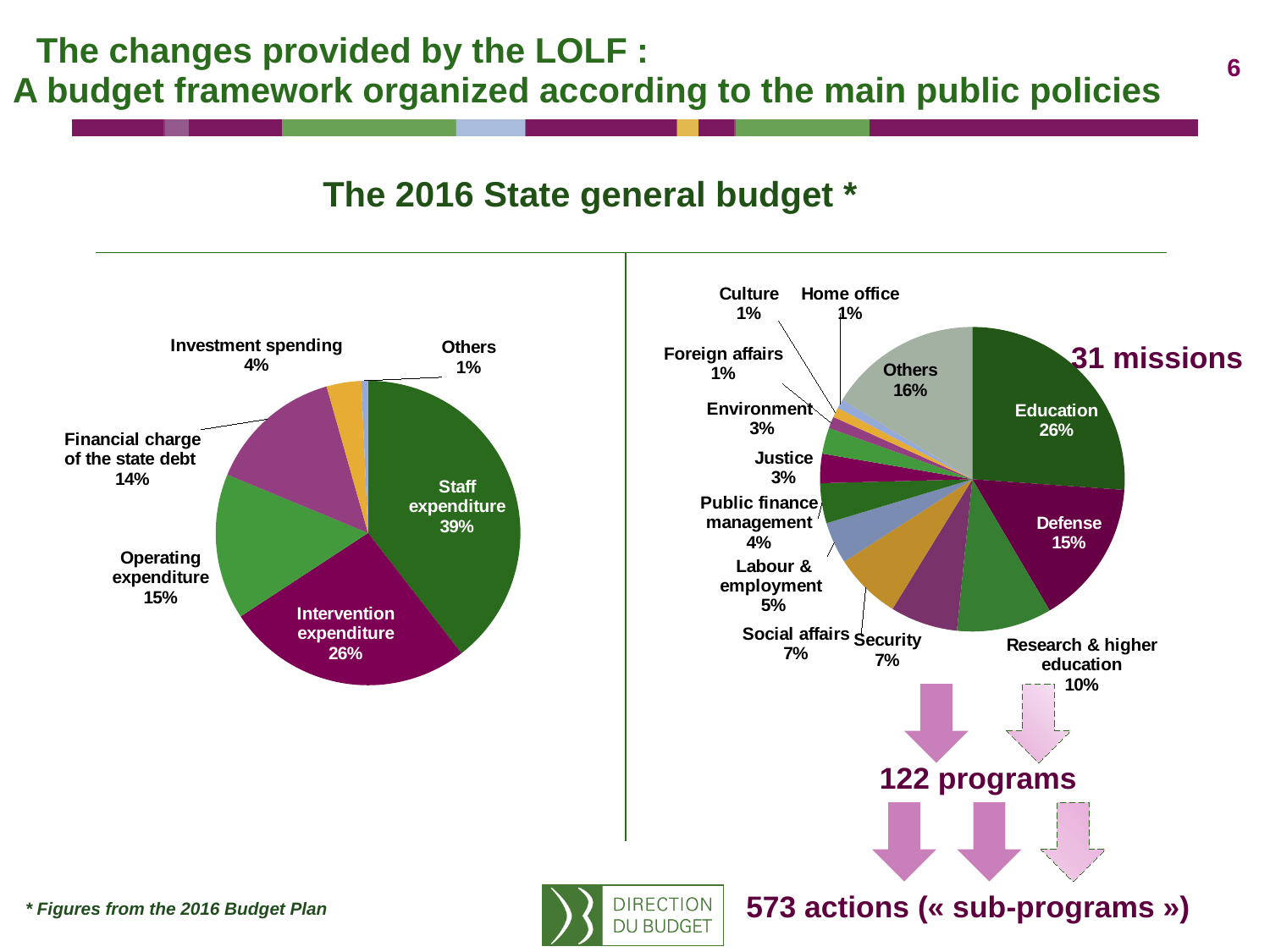
On the left pie chart, which is larger: Operating expenditure or Financial charge of the state debt? Operating expenditure On the left pie chart, which category has the smallest share? Others How many categories does the right pie chart show? 13 How many categories does the left pie chart show? 6 On the right pie chart, what share does Education represent? 26% On the left pie chart, what is the difference between Intervention expenditure and Operating expenditure? 11% On the right pie chart, which named mission (excluding Others) has the largest share? Education What type of chart is used on the left side of the slide? Pie chart On the right pie chart, what is the difference between Research & higher education and Labour & employment? 5% On the right pie chart, what share does Defense represent? 15% On the left pie chart, which category has the largest share? Staff expenditure On the left pie chart, what share does Staff expenditure represent? 39%